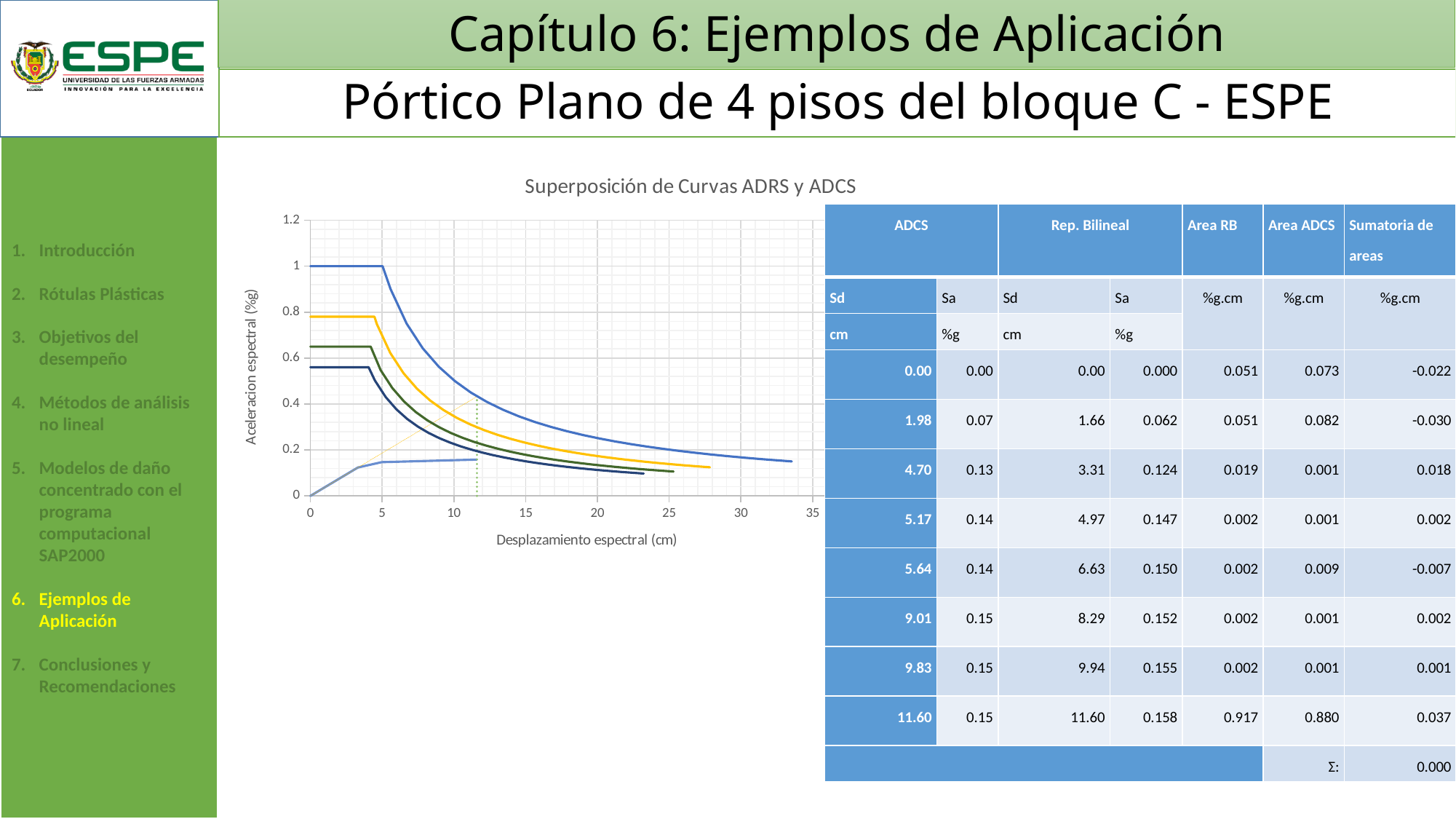
What is the title of the chart? Superposición de Curvas ADRS y ADCS What kind of chart is shown on the slide? line chart Is the plateau value of the dark blue curve greater or less than 0.4? greater Is the maximum value reached by the lowest (capacity) curve greater or less than 0.2? less What is the label of the x axis of the chart? Desplazamiento espectral (cm) Is the vertical dotted green line located at a displacement greater or less than 10 cm? greater What spectral acceleration value does the flat plateau of the topmost (light blue) curve lie on? 1 After their flat plateaus, do the four spectrum curves rise or fall as spectral displacement increases? fall What is the highest tick value shown on the y axis of the chart? 1.2 What is the highest tick value shown on the x axis of the chart? 35